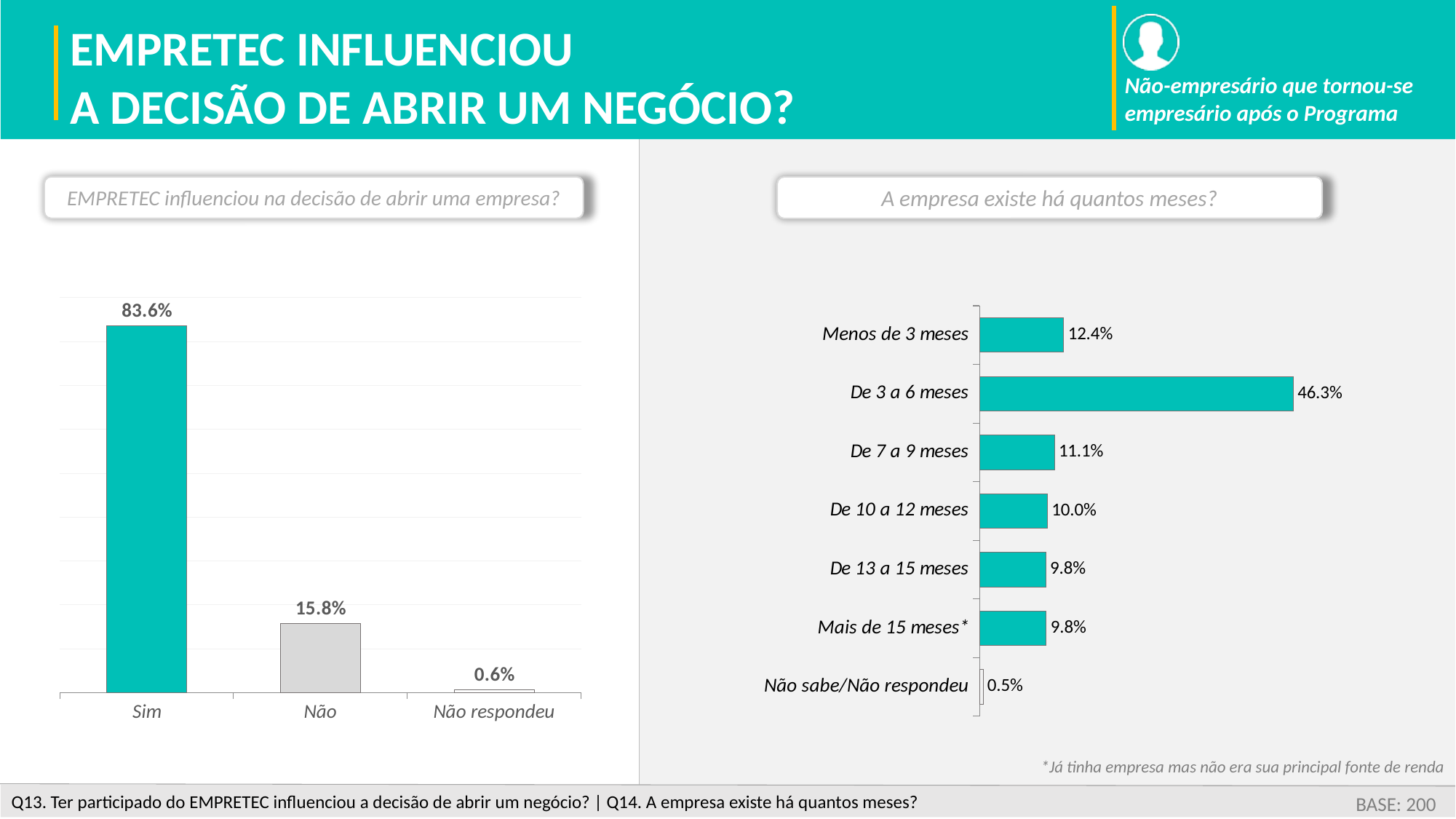
In the left chart 'EMPRETEC influenciou na decisão de abrir uma empresa?', how many categories are shown? 3 In the right chart 'A empresa existe há quantos meses?', which is larger: 'Menos de 3 meses' or 'De 10 a 12 meses'? Menos de 3 meses In the right chart 'A empresa existe há quantos meses?', which category has the highest value? De 3 a 6 meses In the right chart 'A empresa existe há quantos meses?', what is the value for 'De 3 a 6 meses'? 46.3% In the left chart 'EMPRETEC influenciou na decisão de abrir uma empresa?', what is the value for 'Sim'? 83.6% In the left chart 'EMPRETEC influenciou na decisão de abrir uma empresa?', what is the difference between 'Sim' and 'Não'? 67.8% What type of chart is the right chart 'A empresa existe há quantos meses?'? Bar chart In the right chart 'A empresa existe há quantos meses?', which category has the lowest value? Não sabe/Não respondeu In the left chart 'EMPRETEC influenciou na decisão de abrir uma empresa?', what is the value for 'Não'? 15.8% In the right chart 'A empresa existe há quantos meses?', what is the value for 'De 7 a 9 meses'? 11.1% In the right chart 'A empresa existe há quantos meses?', how many categories are shown? 7 In the left chart 'EMPRETEC influenciou na decisão de abrir uma empresa?', which category has the lowest value? Não respondeu